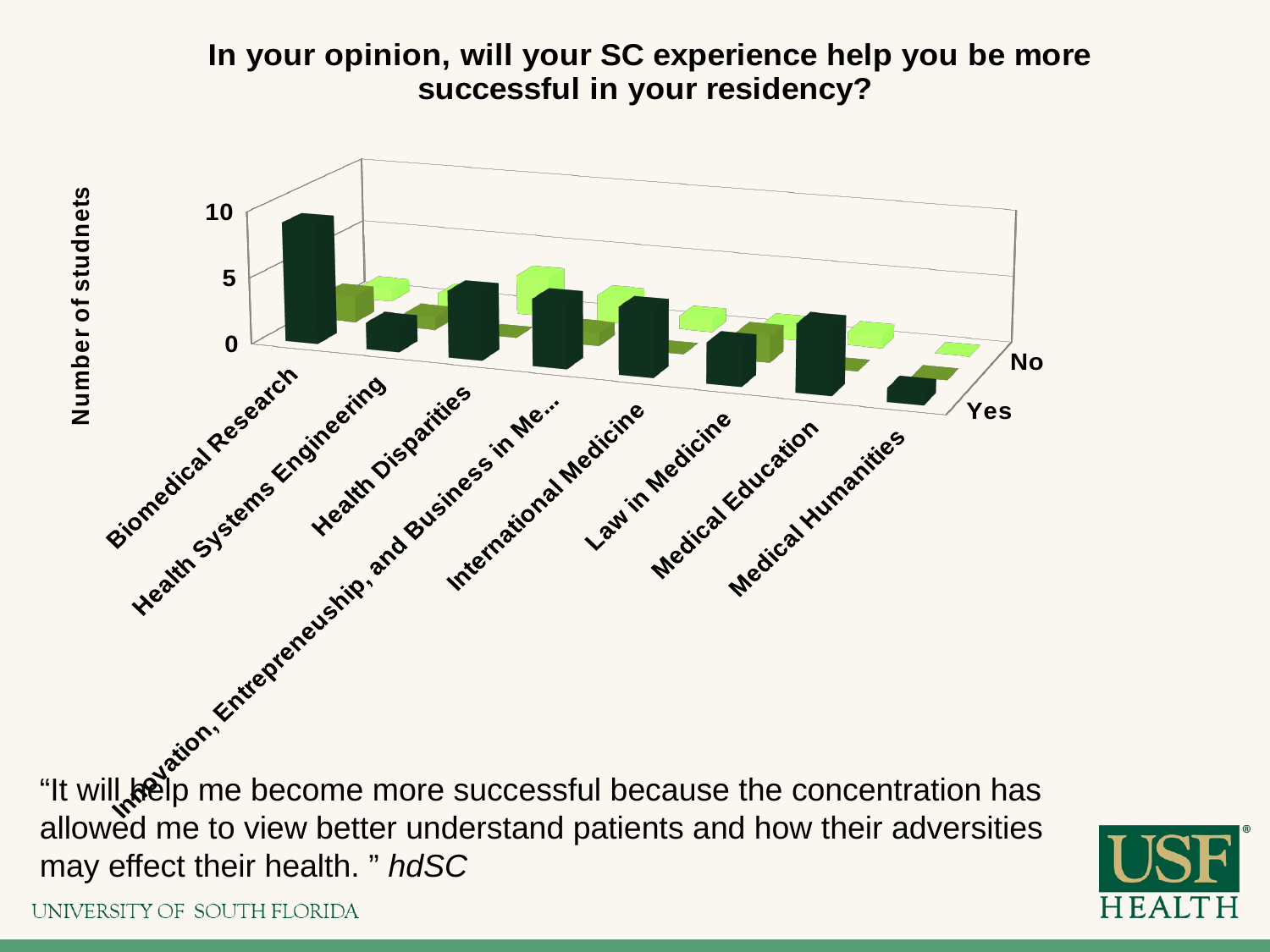
Which has more Yes responses, Health Disparities or Medical Humanities? Health Disparities Which has more Yes responses, Biomedical Research or Medical Education? Biomedical Research How many scholarly concentration categories are shown along the x axis? 8 Is the Yes value for Law in Medicine greater or less than 5? less What is the label on the vertical axis of the chart? Number of studnets Is the Yes value for Medical Humanities greater or less than 5? less What is the title of the chart? In your opinion, will your SC experience help you be more successful in your residency? Which category has the highest number of students answering Yes? Biomedical Research Is the Yes value for Health Systems Engineering greater or less than 5? less What kind of chart is shown on the slide? bar chart Which category has the lowest number of students answering Yes? Medical Humanities